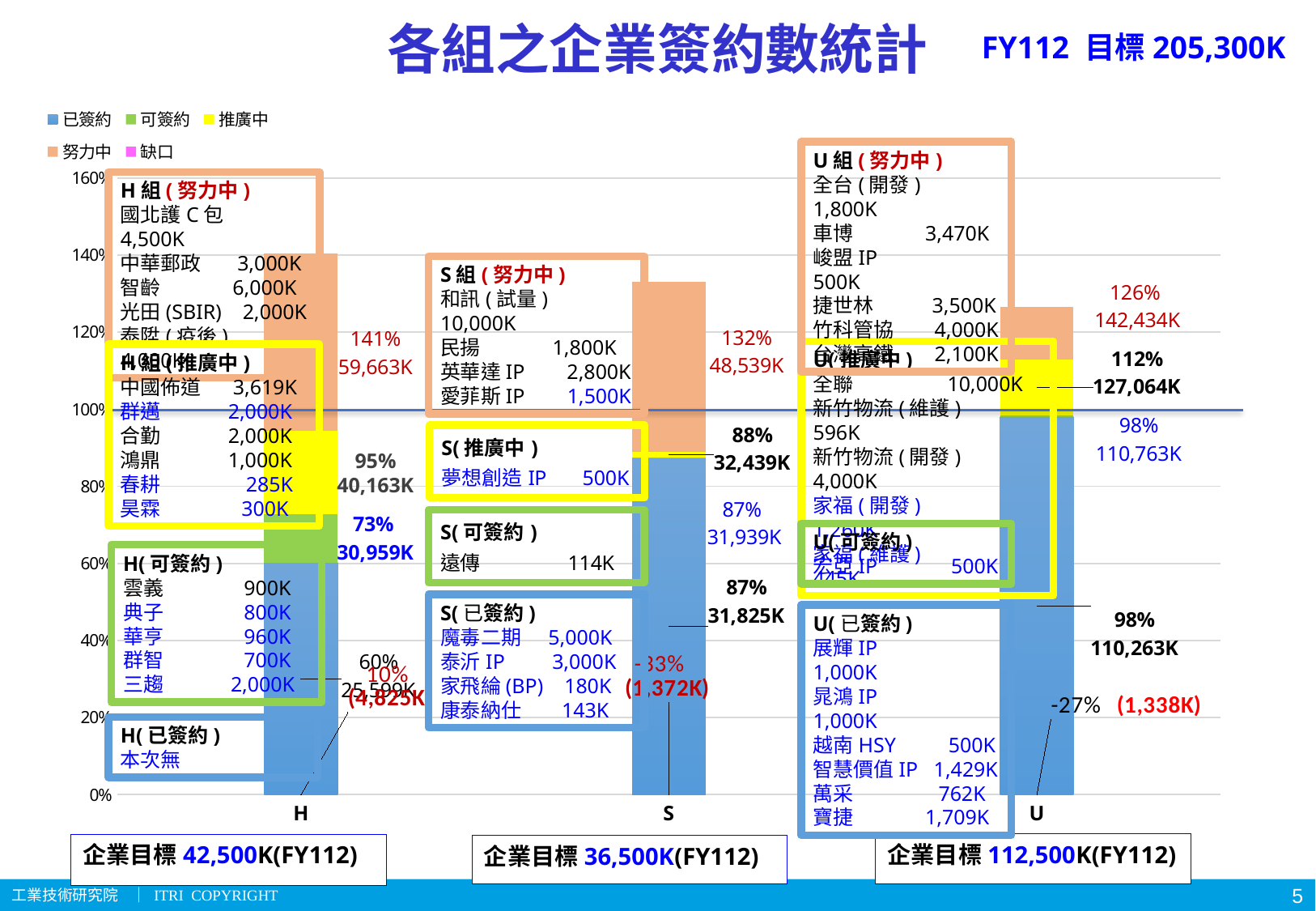
What is the topmost percentage label shown for the S bar? 132% Which bar has the higher topmost percentage label, H or U? H What value in K is shown next to the 88% label on the S bar? 32,439K What value in K is shown next to the 126% label on the U bar? 142,434K How many series does the chart legend list? 5 What is the FY112 目標 value shown at the top right of the slide? 205,300K What is the topmost percentage label shown for the H bar? 141% What value in K is shown next to the 141% label on the H bar? 59,663K What kind of chart is shown on the slide? bar chart What is the 企業目標 (FY112) shown below the U bar? 112,500K How many categories are shown on the x axis of the chart? 3 What are the category labels on the x axis of the chart? H, S, U